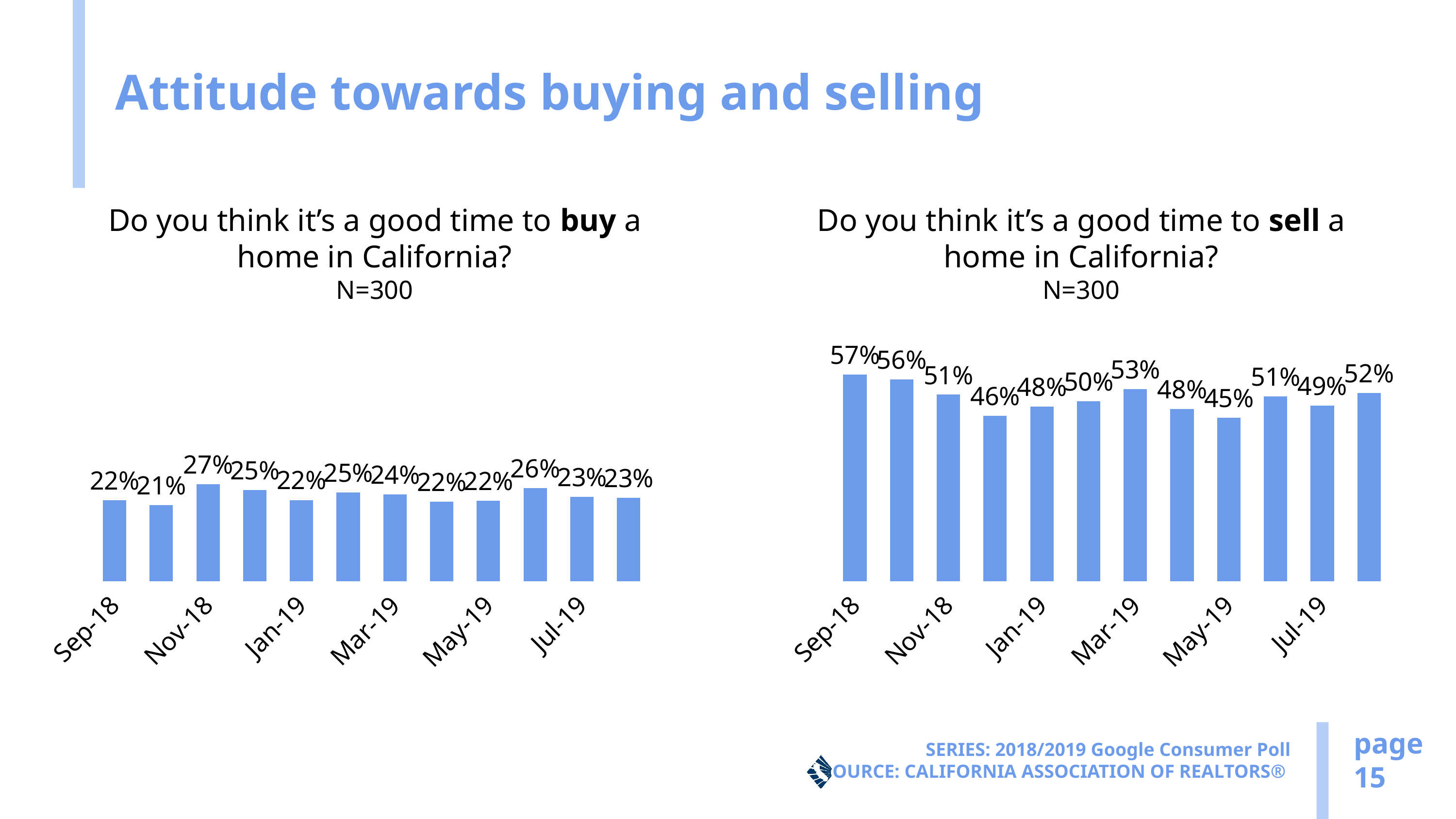
On the 'good time to buy' chart, which is larger, the value for Nov-18 or the value for Jan-19? Nov-18 On the 'good time to buy' chart, which labeled month has the highest value? Nov-18 On the 'good time to sell' chart, what is the value for Mar-19? 53% What kind of chart is the 'good time to buy' chart? Bar chart On the 'good time to buy' chart, what is the value for Sep-18? 22% On the 'good time to sell' chart, which month has the lowest value? May-19 How many bars are plotted on the 'good time to sell' chart? 12 On the 'good time to sell' chart, what is the value for May-19? 45% On the 'good time to buy' chart, what is the value for Nov-18? 27% On the 'good time to sell' chart, which month has the highest value? Sep-18 On the 'good time to sell' chart, what is the value for Sep-18? 57% On the 'good time to sell' chart, what is the difference between the Sep-18 value and the May-19 value? 12%